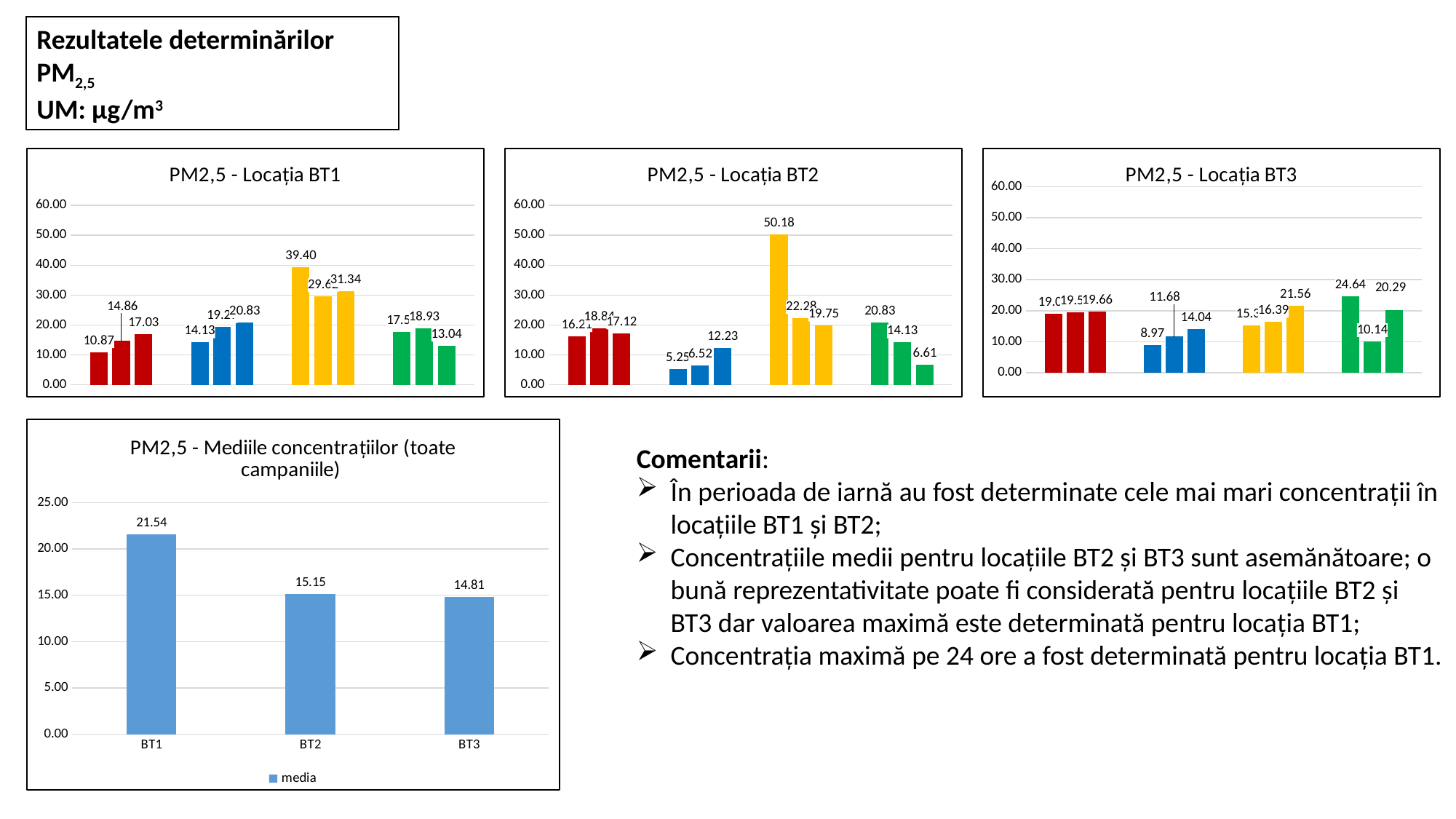
In the chart titled 'PM2,5 - Mediile concentrațiilor (toate campaniile)', do the values rise or fall from BT1 to BT3? fall What kind of chart is 'PM2,5 - Locația BT3'? bar chart In the chart titled 'PM2,5 - Mediile concentrațiilor (toate campaniile)', what is the difference between the values for BT1 and BT2? 6.39 In the chart titled 'PM2,5 - Mediile concentrațiilor (toate campaniile)', what is the name of the series in the legend? media In the chart titled 'PM2,5 - Locația BT2', what is the highest value shown? 50.18 In the chart titled 'PM2,5 - Mediile concentrațiilor (toate campaniile)', how many locations are shown on the x axis? 3 In the chart titled 'PM2,5 - Mediile concentrațiilor (toate campaniile)', what is the value for BT1? 21.54 In the chart titled 'PM2,5 - Mediile concentrațiilor (toate campaniile)', which location has the highest value? BT1 In the chart titled 'PM2,5 - Mediile concentrațiilor (toate campaniile)', which location has the lowest value? BT3 In the chart titled 'PM2,5 - Mediile concentrațiilor (toate campaniile)', what is the value for BT3? 14.81 In the chart titled 'PM2,5 - Locația BT1', what is the highest value shown? 39.40 In the chart titled 'PM2,5 - Mediile concentrațiilor (toate campaniile)', what is the value for BT2? 15.15